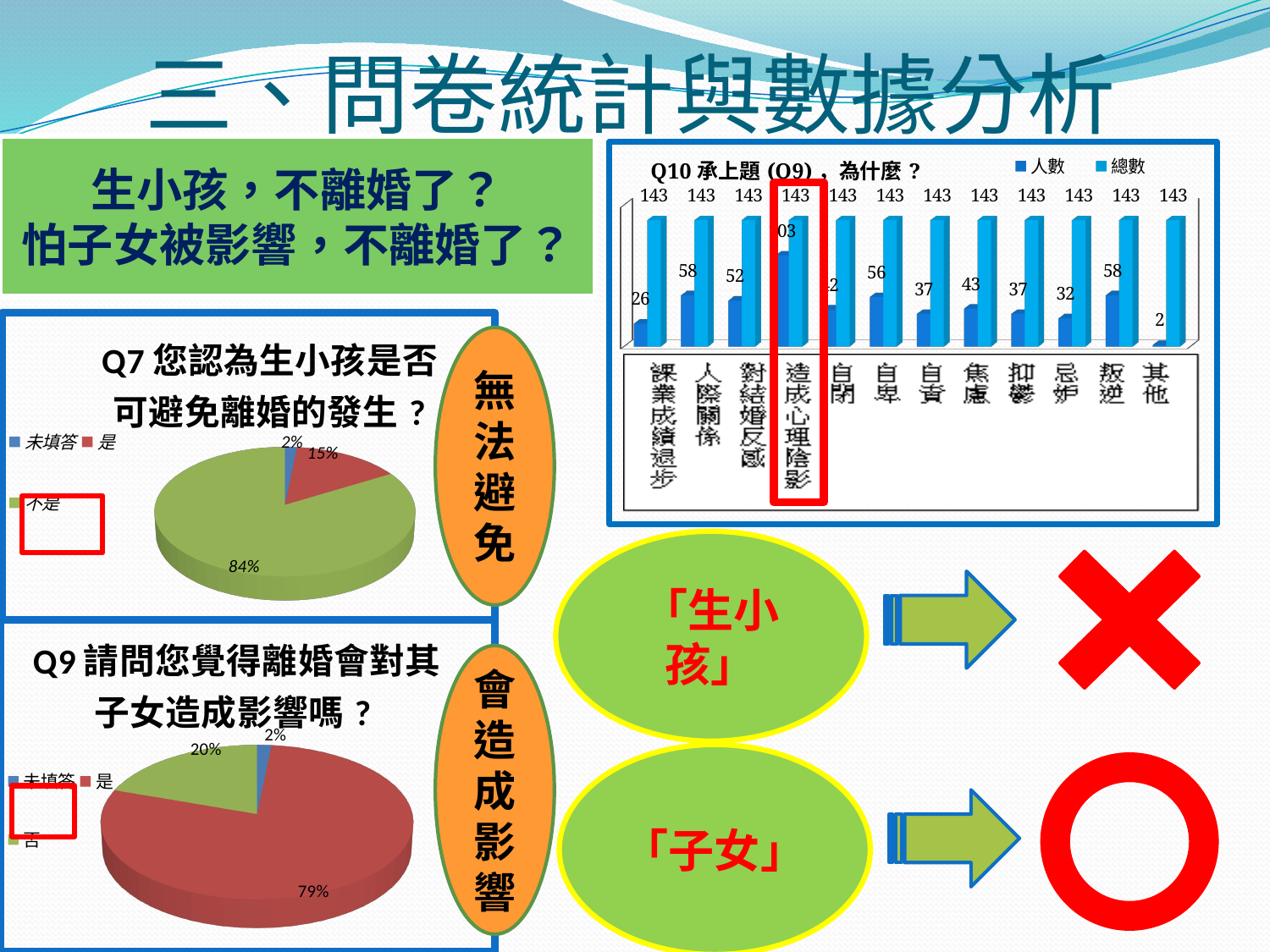
In the Q10 bar chart, which category has the highest 人數 value? 造成心理陰影 In the Q7 pie chart, what share of responses is 不是? 84% In the Q9 pie chart, what share of responses is 是? 79% In the Q10 bar chart, what is the 人數 value for 人際關係? 58 What kind of chart is used for Q9 請問您覺得離婚會對其子女造成影響嗎? pie chart In the Q10 bar chart, which category has the lowest 人數 value? 其他 In the Q10 bar chart, what is the 人數 value for 課業成績退步? 26 In the Q10 bar chart, what is the 人數 value for 忌妒? 32 In the Q10 bar chart, which has a larger 人數 value, 對結婚反感 or 焦慮? 對結婚反感 In the Q10 bar chart, what is the difference between the 人數 values for 自卑 and 自責? 19 How many series does the legend of the Q10 chart list? 2 How many categories are shown in the Q10 bar chart? 12